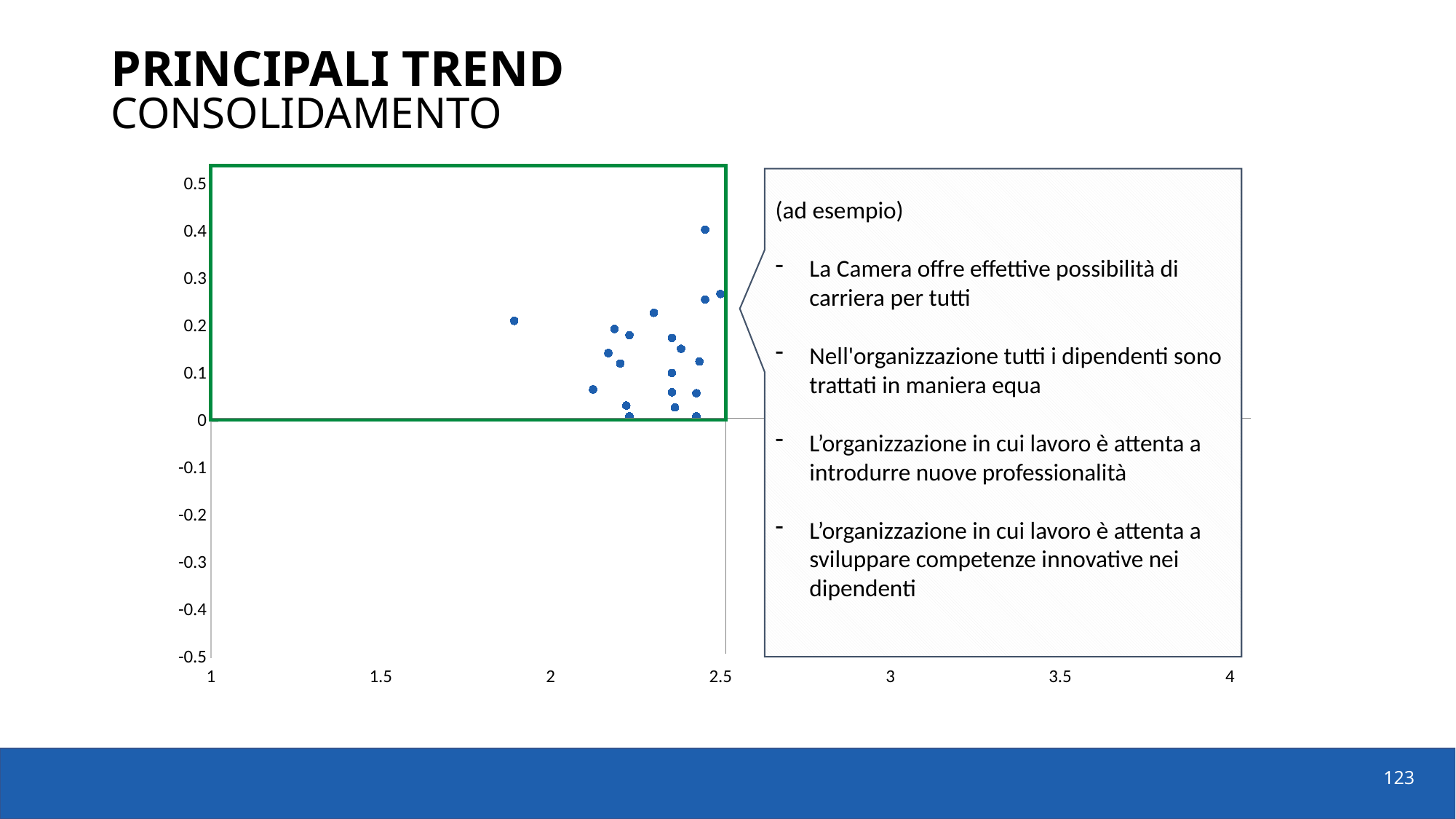
What is the highest value labelled on the vertical axis? 0.5 Are any points plotted below 0 on the vertical axis? No Is the x value of the leftmost plotted point greater or less than 1.5? greater Are any points plotted to the right of 2.5 on the horizontal axis? No What kind of chart is shown on the slide? scatter chart What is the highest value labelled on the horizontal axis? 4